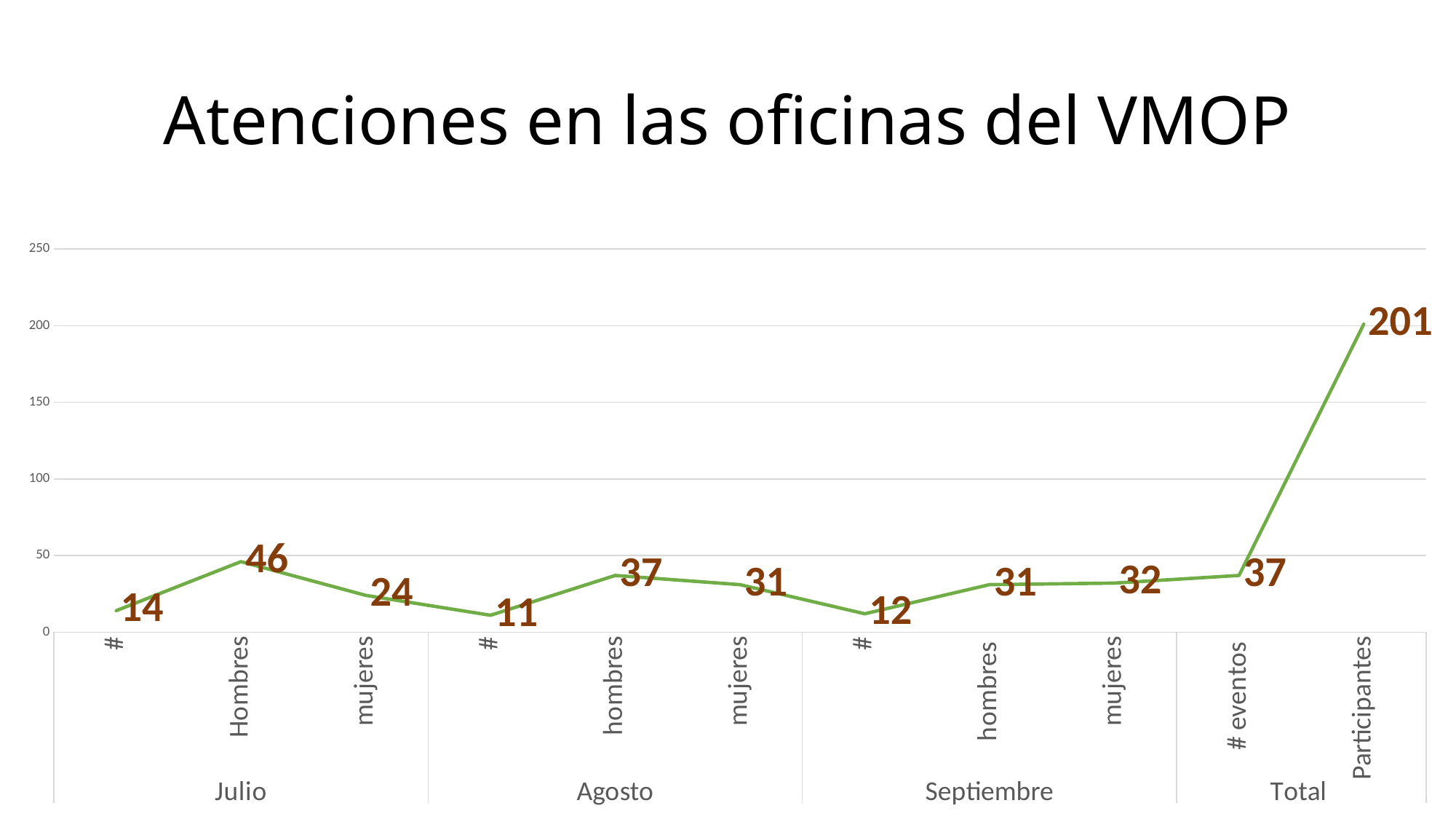
What is the value for Hombres in Julio? 46 What type of chart is shown on the slide? line chart Which data point has the highest value? Participantes (Total) What is the difference between Hombres in Julio and mujeres in Julio? 22 Is the value for Participantes greater or less than 150? greater What is the value for mujeres in Agosto? 31 What is the title of the chart? Atenciones en las oficinas del VMOP What is the value for # in Septiembre? 12 How many data points are plotted on the line? 11 Which data point has the lowest value? # in Agosto Which is larger, hombres in Agosto or hombres in Septiembre? hombres in Agosto What is the value for Participantes under Total? 201